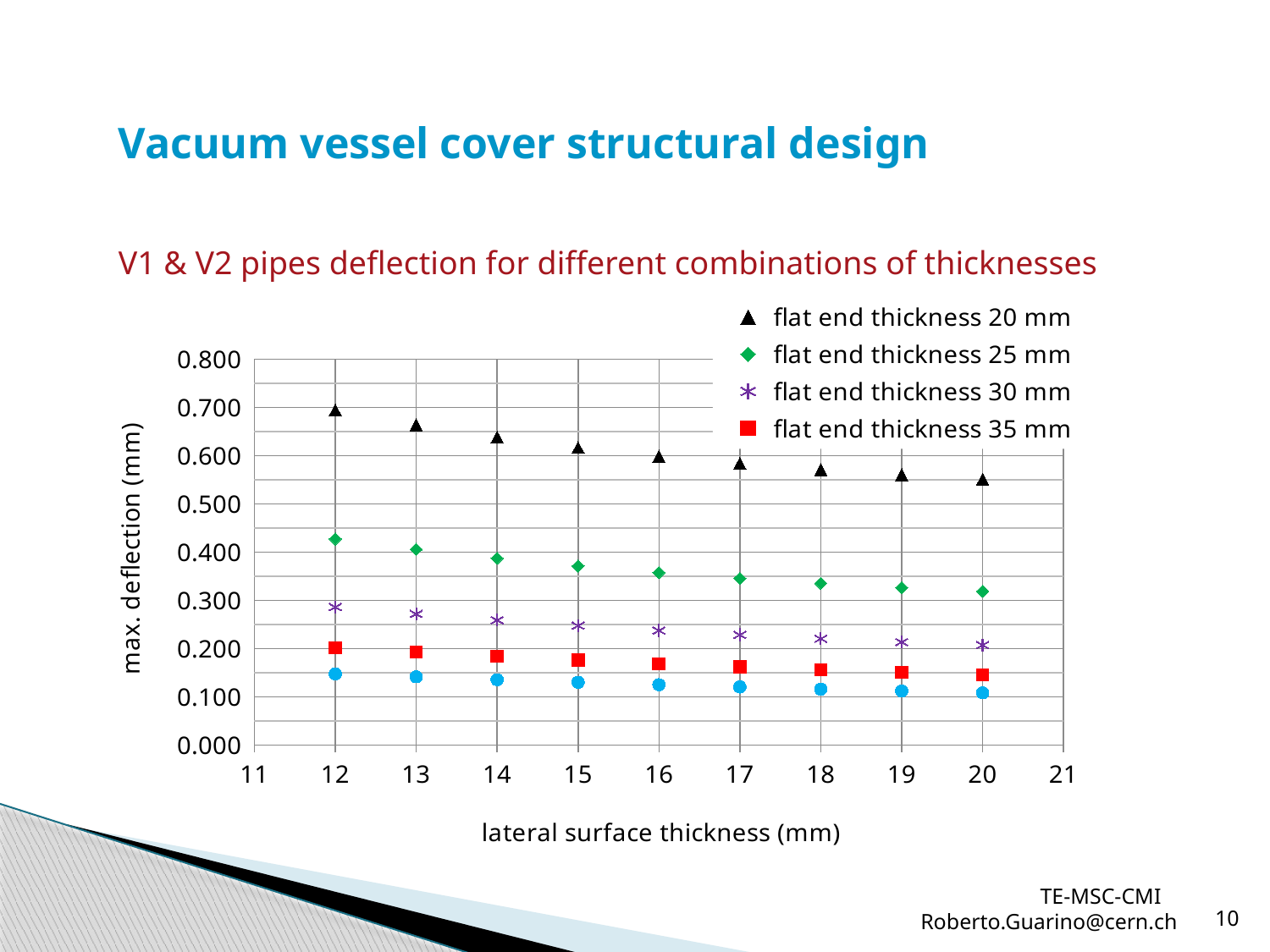
What kind of chart is shown on the slide? scatter chart Is the max. deflection for 'flat end thickness 20 mm' at a lateral surface thickness of 12 mm greater or less than 0.600? greater At a lateral surface thickness of 15 mm, which series has the higher max. deflection: 'flat end thickness 20 mm' or 'flat end thickness 25 mm'? flat end thickness 20 mm How many data points are plotted for the 'flat end thickness 20 mm' series? 9 Does the max. deflection for 'flat end thickness 20 mm' rise or fall as lateral surface thickness increases? fall Is the max. deflection for 'flat end thickness 25 mm' at a lateral surface thickness of 20 mm greater or less than 0.400? less How many series does the legend list? 4 Among the series listed in the legend, which has the lowest max. deflection at a lateral surface thickness of 16 mm? flat end thickness 35 mm Is the max. deflection for 'flat end thickness 35 mm' at a lateral surface thickness of 12 mm greater or less than 0.300? less What is the label of the x axis? lateral surface thickness (mm) At which lateral surface thickness is the max. deflection for 'flat end thickness 25 mm' highest? 12